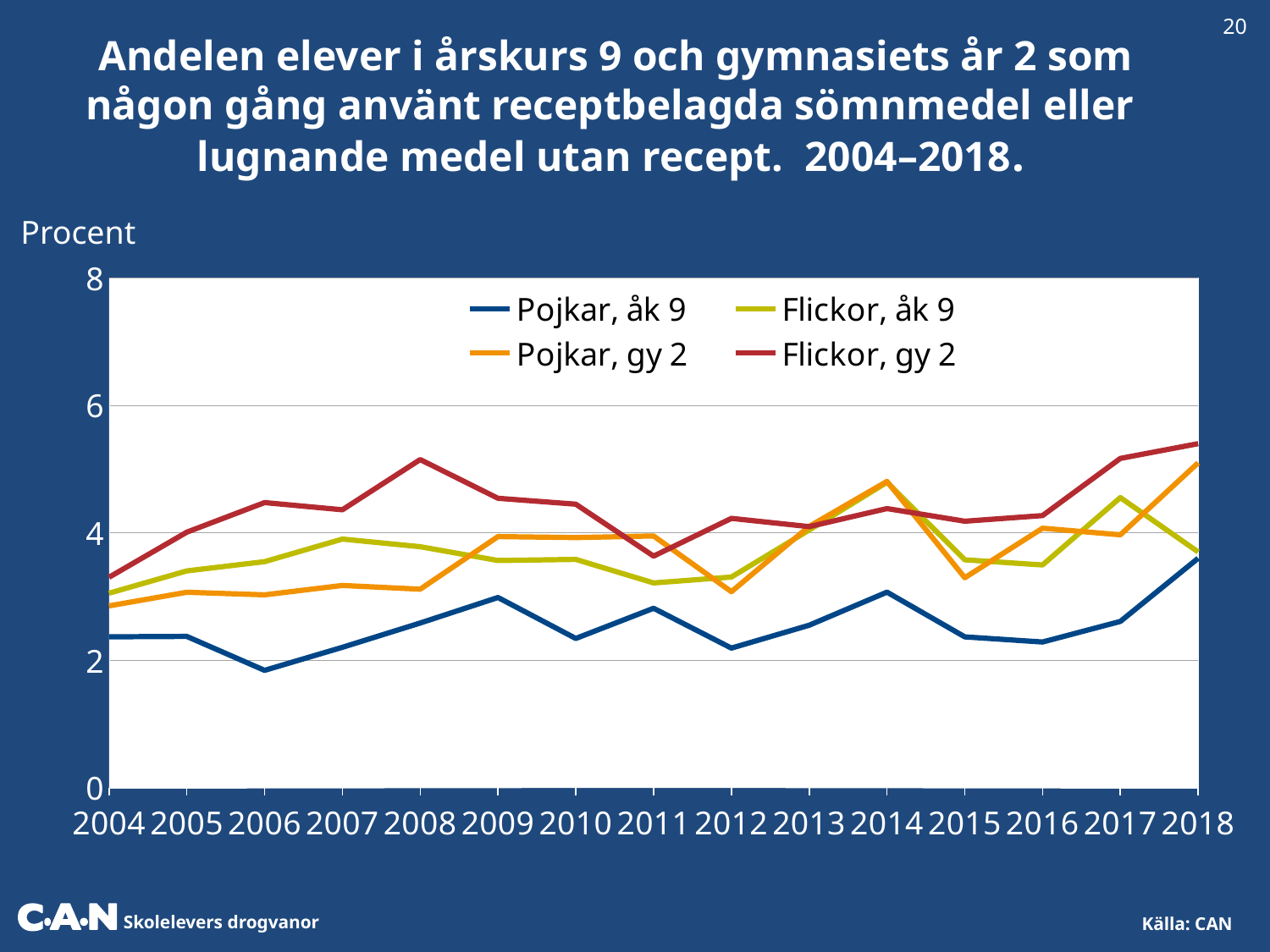
Is the value for Pojkar, gy 2 in 2004 greater or less than 4? less Which series has the highest value in 2008? Flickor, gy 2 Does the value for Pojkar, åk 9 rise or fall from 2016 to 2018? rise How many series does the legend list? 4 In which year is the value for Pojkar, åk 9 lowest? 2006 Is the value for Flickor, gy 2 in 2008 greater or less than 4? greater In 2018, which is larger: Flickor, gy 2 or Pojkar, åk 9? Flickor, gy 2 Is the value for Pojkar, åk 9 in 2018 greater or less than 4? less How many years are shown on the x axis? 15 What kind of chart is shown on the slide? line chart Which series has the lowest value in 2004? Pojkar, åk 9